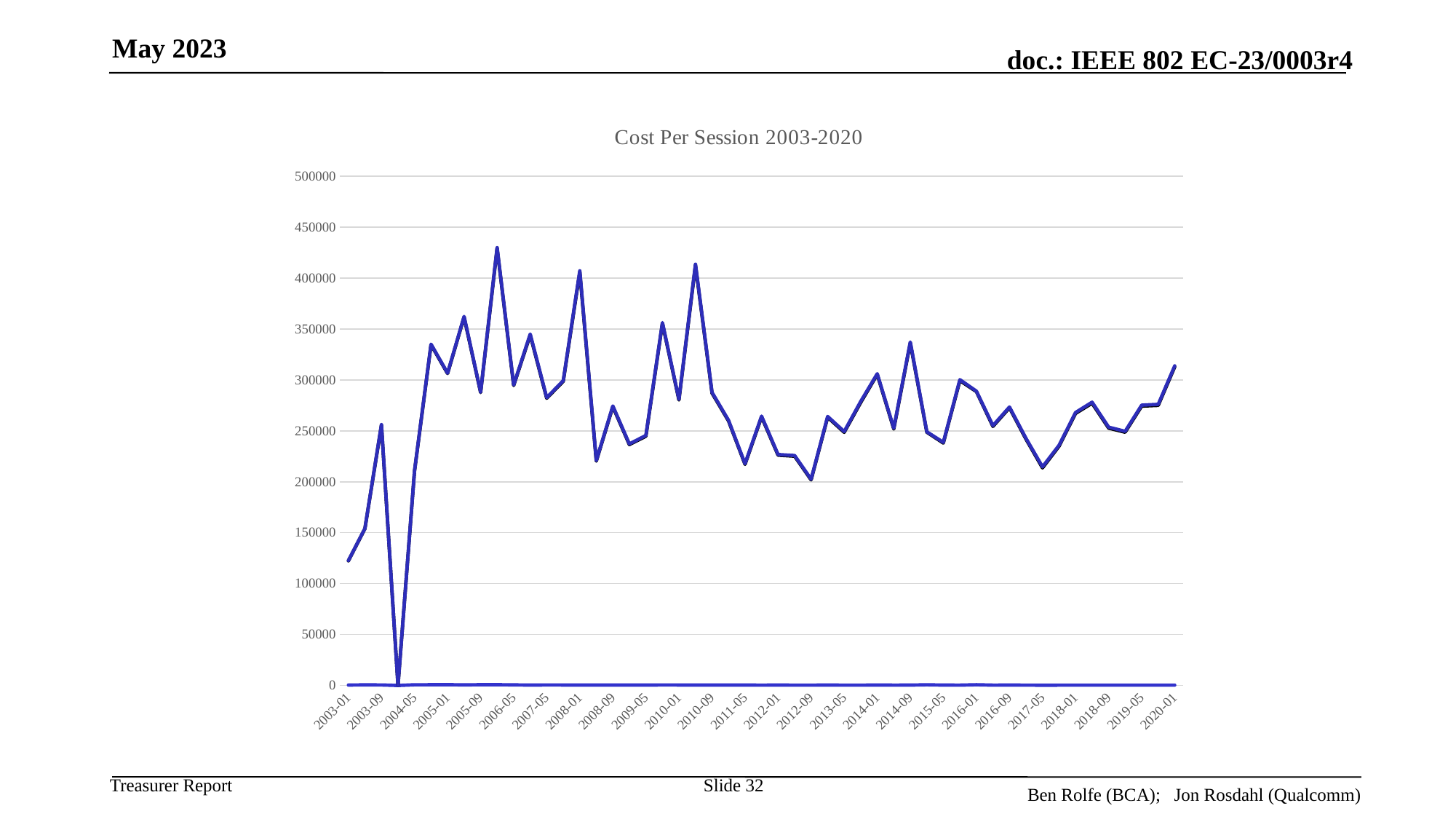
Is the value for 2003-01 greater or less than 200000? less Which is larger, the value for 2020-01 or the value for 2003-01? 2020-01 Is the highest value on the line greater or less than 400000? greater Is the value for 2005-09 greater or less than 250000? greater Does the line rise or fall between 2018-09 and 2020-01? rise What is the lowest value plotted on the line? 0 What kind of chart is shown on the slide? line chart What is the title of the chart? Cost Per Session 2003-2020